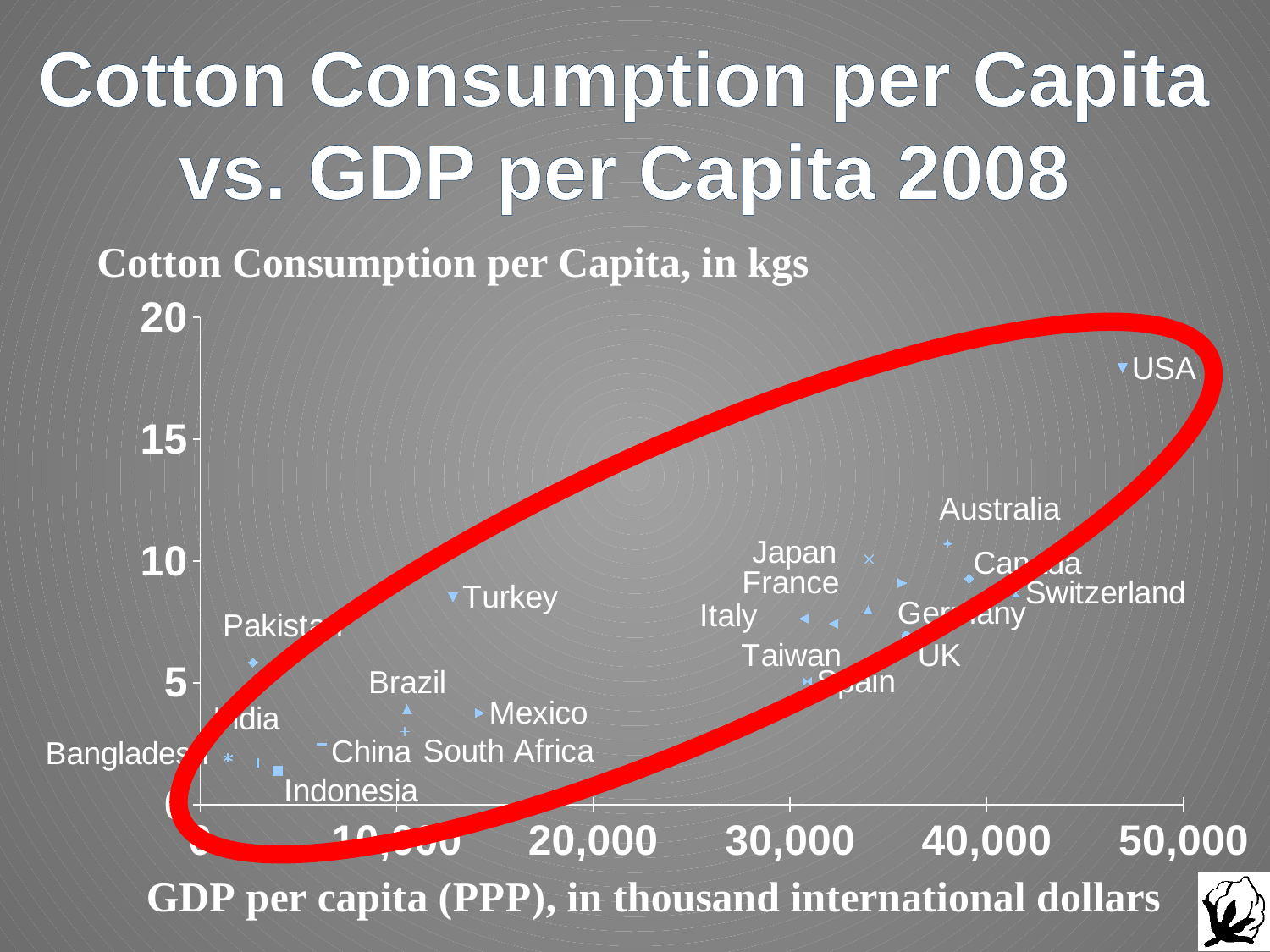
Is the cotton consumption per capita for the USA greater or less than 15 kgs? greater Does cotton consumption per capita generally rise or fall as GDP per capita increases? rise What is the label of the vertical axis? Cotton Consumption per Capita, in kgs Is the GDP per capita for the USA greater or less than 40,000? greater Is the cotton consumption per capita for Australia greater or less than 10 kgs? greater Which has higher cotton consumption per capita, Australia or Brazil? Australia Which country has the highest cotton consumption per capita? USA What kind of chart is shown on the slide? scatter chart Which has higher cotton consumption per capita, the USA or Turkey? USA